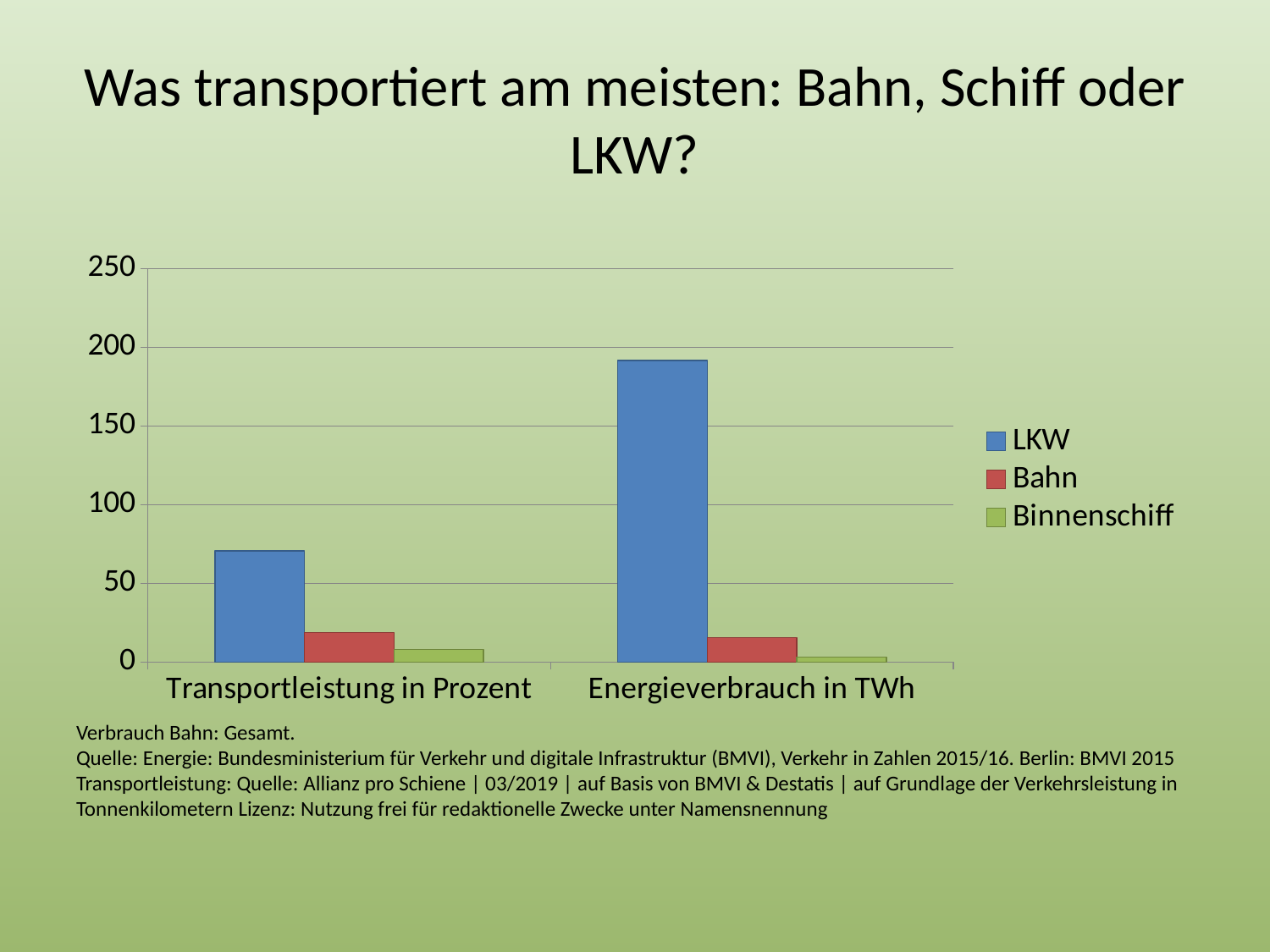
How many categories are shown on the x axis? 2 How many series does the legend list? 3 Which series has the highest value for Energieverbrauch in TWh? LKW Which colour represents Bahn in the legend? red What kind of chart is shown on the slide? bar chart Is the value for Bahn in Energieverbrauch in TWh greater or less than 50? less Which series has the lowest value for Transportleistung in Prozent? Binnenschiff Is the value for LKW in Transportleistung in Prozent greater or less than 100? less Which is larger for Transportleistung in Prozent: Bahn or Binnenschiff? Bahn Which series has the lowest value for Energieverbrauch in TWh? Binnenschiff Is the value for LKW in Energieverbrauch in TWh greater or less than 150? greater Which is larger: the LKW value for Transportleistung in Prozent or the LKW value for Energieverbrauch in TWh? Energieverbrauch in TWh